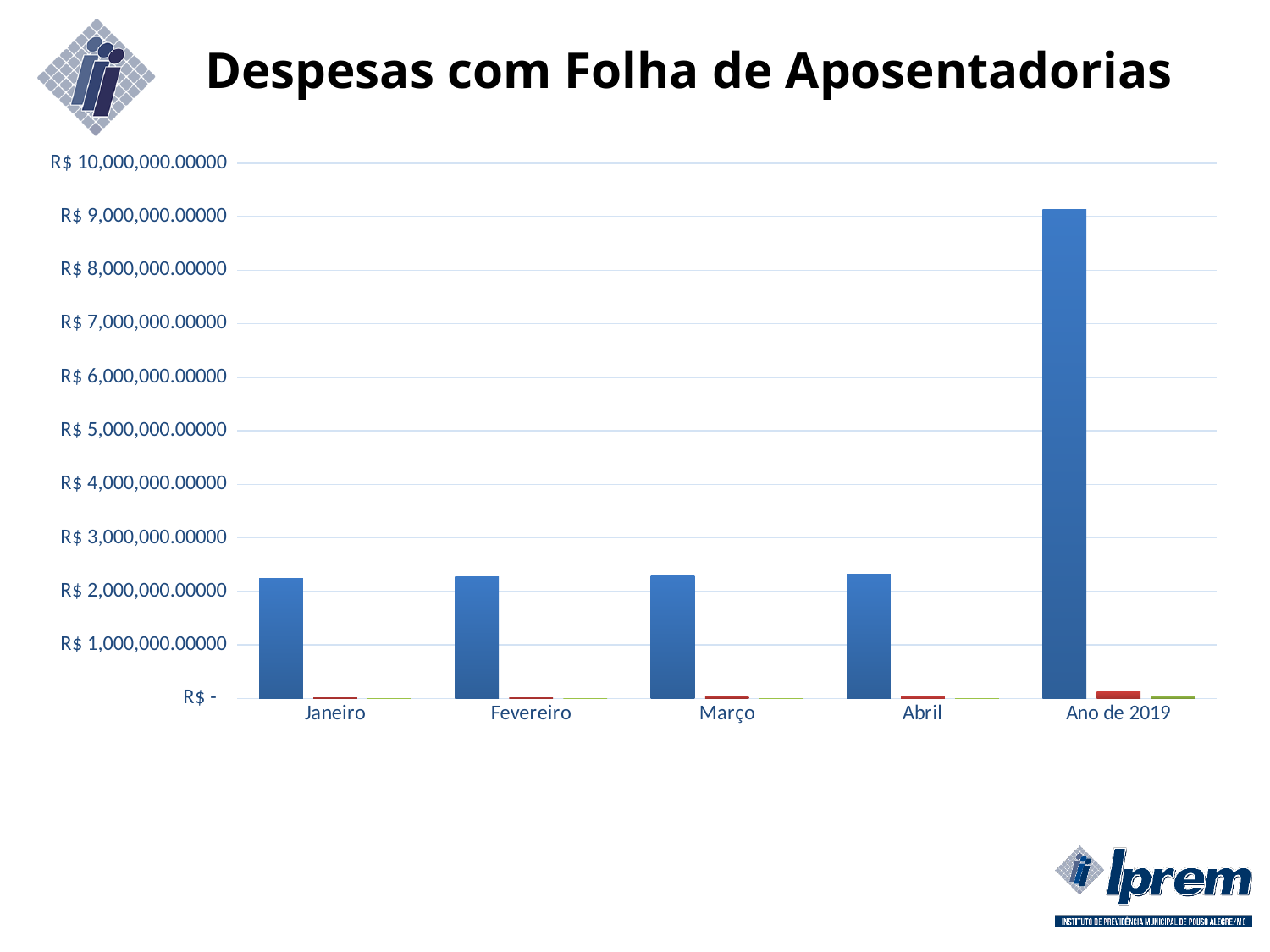
What kind of chart is shown on the slide? bar chart Is the blue bar for Janeiro greater or less than R$ 3,000,000.00000? less How many categories are shown on the x axis? 5 What is the title of the chart? Despesas com Folha de Aposentadorias Is the blue bar for Abril greater or less than R$ 2,000,000.00000? greater What is the label of the last category on the x axis? Ano de 2019 Which category has the tallest blue bar? Ano de 2019 Is the blue bar for Ano de 2019 greater or less than R$ 8,000,000.00000? greater Which has the larger blue bar, Fevereiro or Ano de 2019? Ano de 2019 What is the highest value labelled on the y axis? R$ 10,000,000.00000 Which has the larger blue bar, Abril or Ano de 2019? Ano de 2019